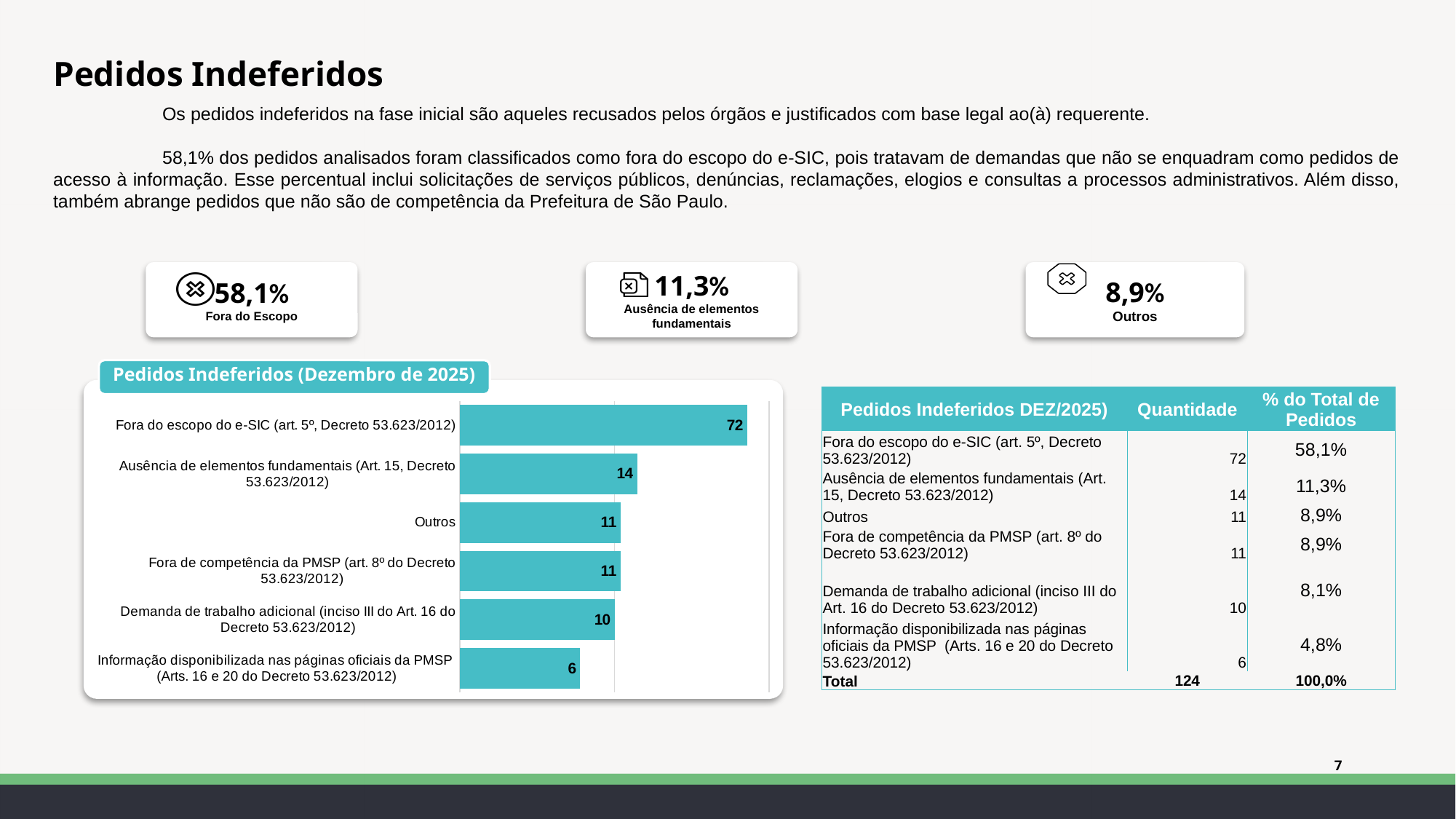
Which is larger in the bar chart: the value for "Demanda de trabalho adicional" or the value for "Informação disponibilizada nas páginas oficiais da PMSP"? Demanda de trabalho adicional What is the value for "Outros" in the bar chart? 11 Which category has the lowest value in the bar chart? Informação disponibilizada nas páginas oficiais da PMSP (Arts. 16 e 20 do Decreto 53.623/2012) What is the value for "Informação disponibilizada nas páginas oficiais da PMSP (Arts. 16 e 20 do Decreto 53.623/2012)" in the bar chart? 6 What is the value for "Fora do escopo do e-SIC (art. 5º, Decreto 53.623/2012)" in the bar chart? 72 Which category has the highest value in the bar chart? Fora do escopo do e-SIC (art. 5º, Decreto 53.623/2012) What is the difference between the values for "Fora do escopo do e-SIC" and "Ausência de elementos fundamentais" in the bar chart? 58 How many categories does the bar chart show? 6 What is the title of the bar chart? Pedidos Indeferidos (Dezembro de 2025) What type of chart is shown on the slide? bar chart What is the value for "Demanda de trabalho adicional (inciso III do Art. 16 do Decreto 53.623/2012)" in the bar chart? 10 What is the value for "Ausência de elementos fundamentais (Art. 15, Decreto 53.623/2012)" in the bar chart? 14